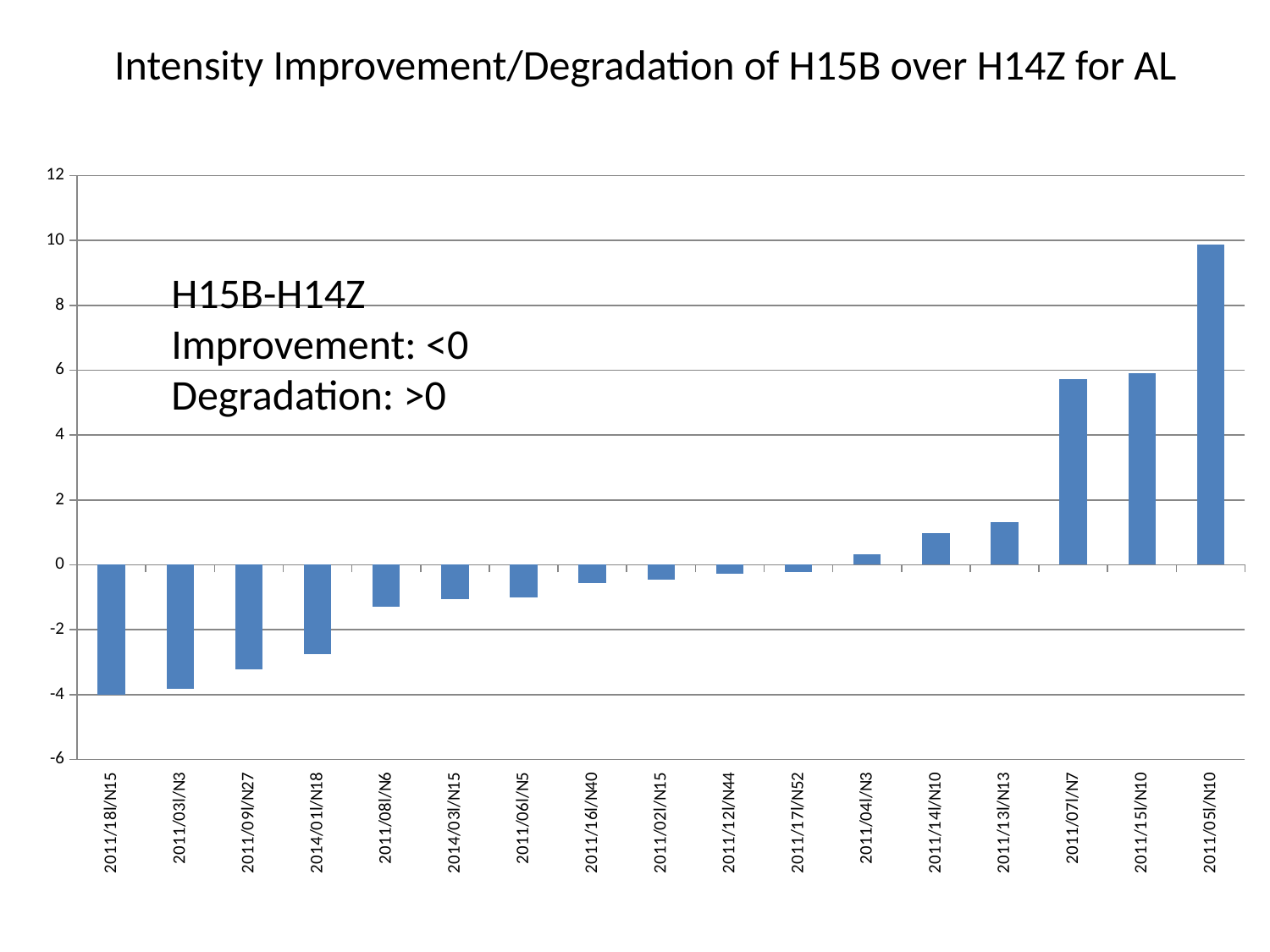
Is the value for 2011/07l/N7 greater or less than 4? greater Is the value for 2011/05l/N10 greater or less than 8? greater Which has the larger value, 2011/05l/N10 or 2011/07l/N7? 2011/05l/N10 What is the title of the chart? Intensity Improvement/Degradation of H15B over H14Z for AL Is the value for 2011/18l/N15 greater or less than -2? less Which has the larger value, 2011/18l/N15 or 2011/08l/N6? 2011/08l/N6 Which category has the highest value? 2011/05l/N10 How many categories are plotted along the x axis? 17 What kind of chart is shown on the slide? bar chart Do the values generally rise or fall from left to right along the x axis? rise